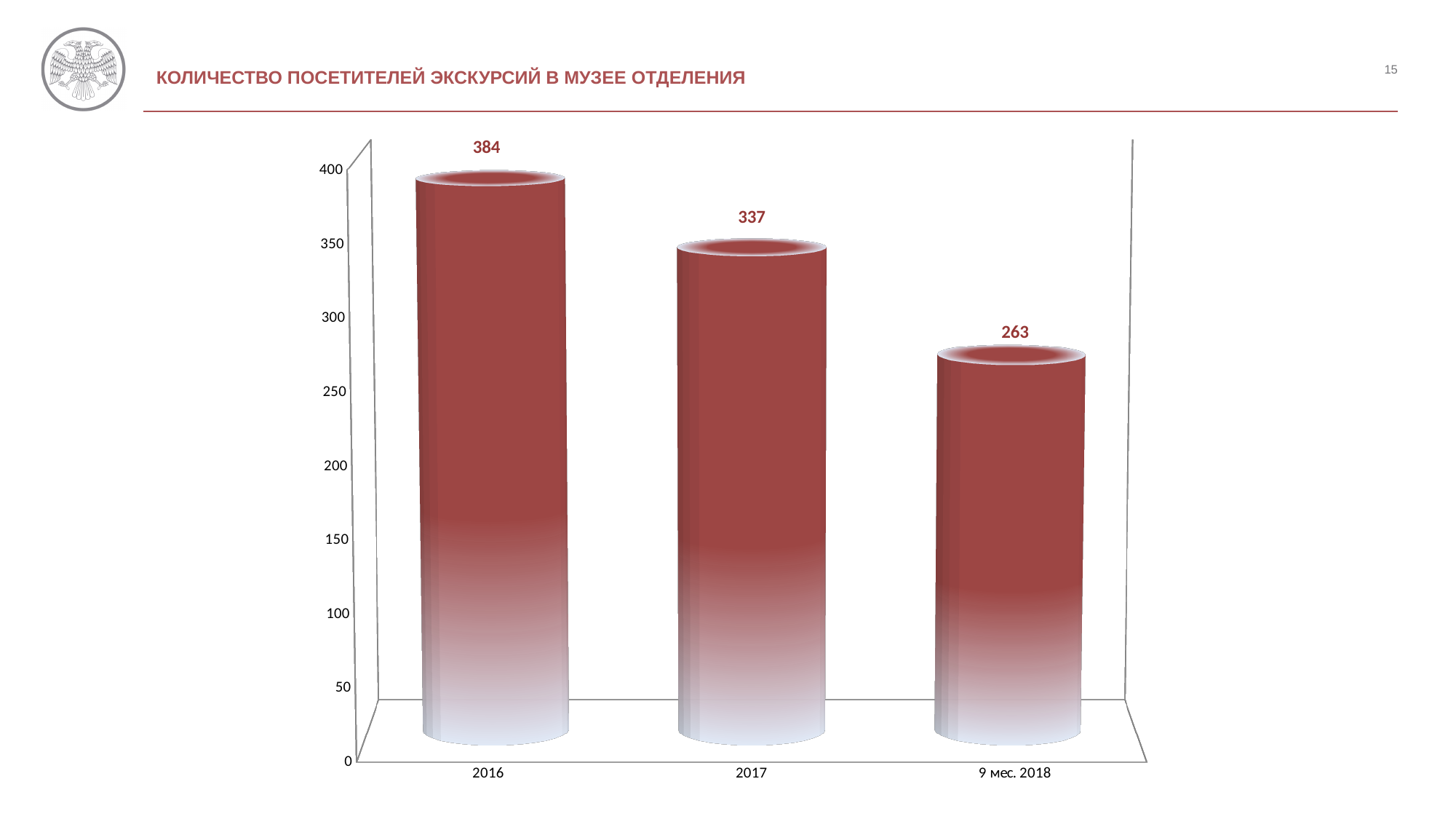
What is the value for 2017? 337 What is the difference between the values for 2017 and 9 мес. 2018? 74 What kind of chart is shown on the slide? bar chart Which category has the lowest value? 9 мес. 2018 What is the difference between the values for 2016 and 2017? 47 Is the value for 9 мес. 2018 greater or less than 300? less What is the value for 2016? 384 Do the values rise or fall from 2016 to 9 мес. 2018? fall Which category has the highest value? 2016 What is the value for 9 мес. 2018? 263 Which is larger, the value for 2017 or the value for 9 мес. 2018? 2017 How many categories are shown on the x axis? 3